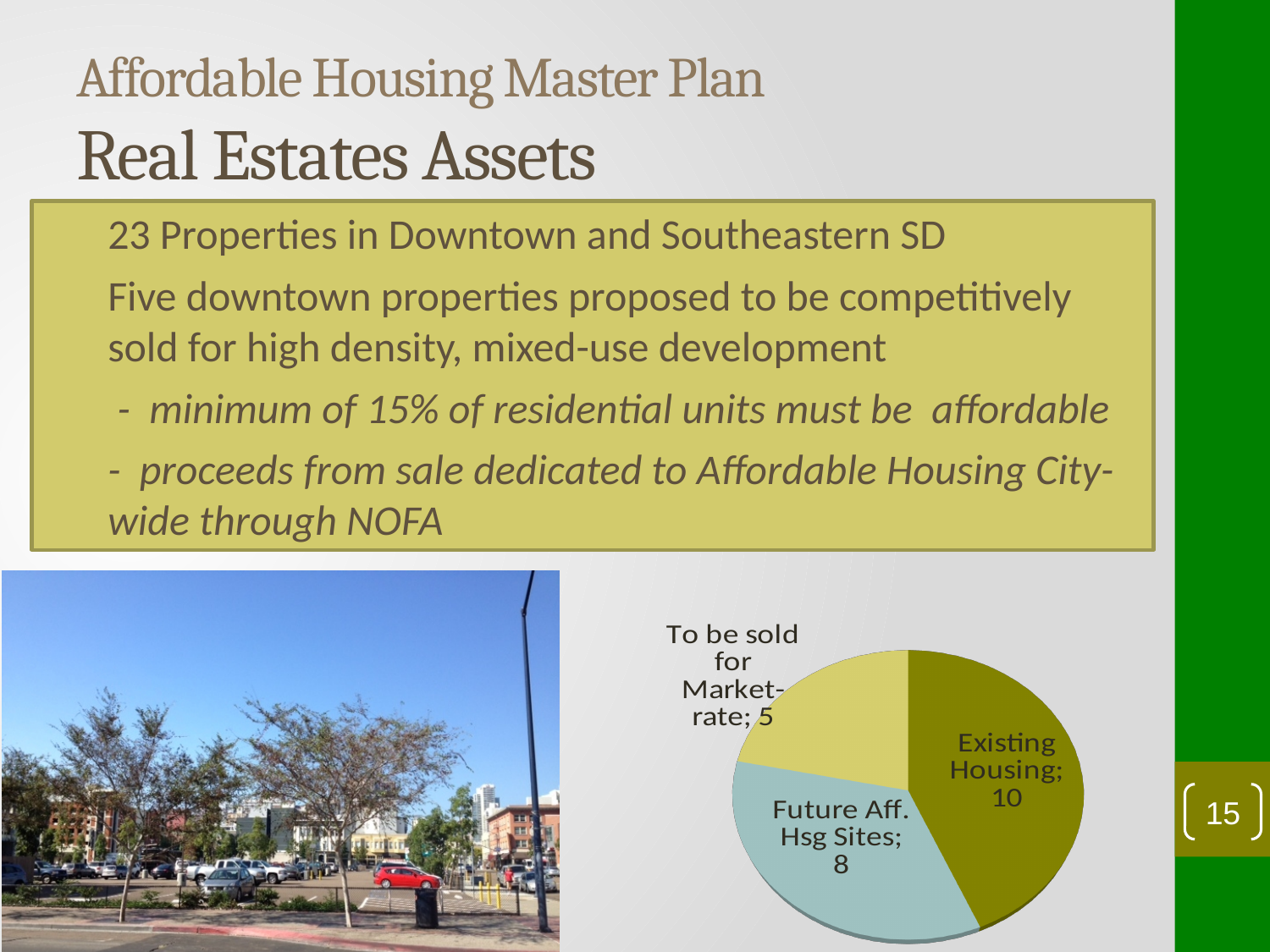
What share of the pie chart total does Existing Housing represent? 10 of 23 Which slice of the pie chart has the smallest value? To be sold for Market-rate What is the value for Future Aff. Hsg Sites in the pie chart? 8 What is the difference between the Existing Housing value and the To be sold for Market-rate value? 5 What is the difference between the Existing Housing value and the Future Aff. Hsg Sites value? 2 What is the value for Existing Housing in the pie chart? 10 What is the value for To be sold for Market-rate in the pie chart? 5 How many slices does the pie chart have? 3 Which slice of the pie chart has the largest value? Existing Housing What is the total of all slices in the pie chart? 23 What type of chart is shown on the slide? pie chart Which is larger in the pie chart: Future Aff. Hsg Sites or To be sold for Market-rate? Future Aff. Hsg Sites